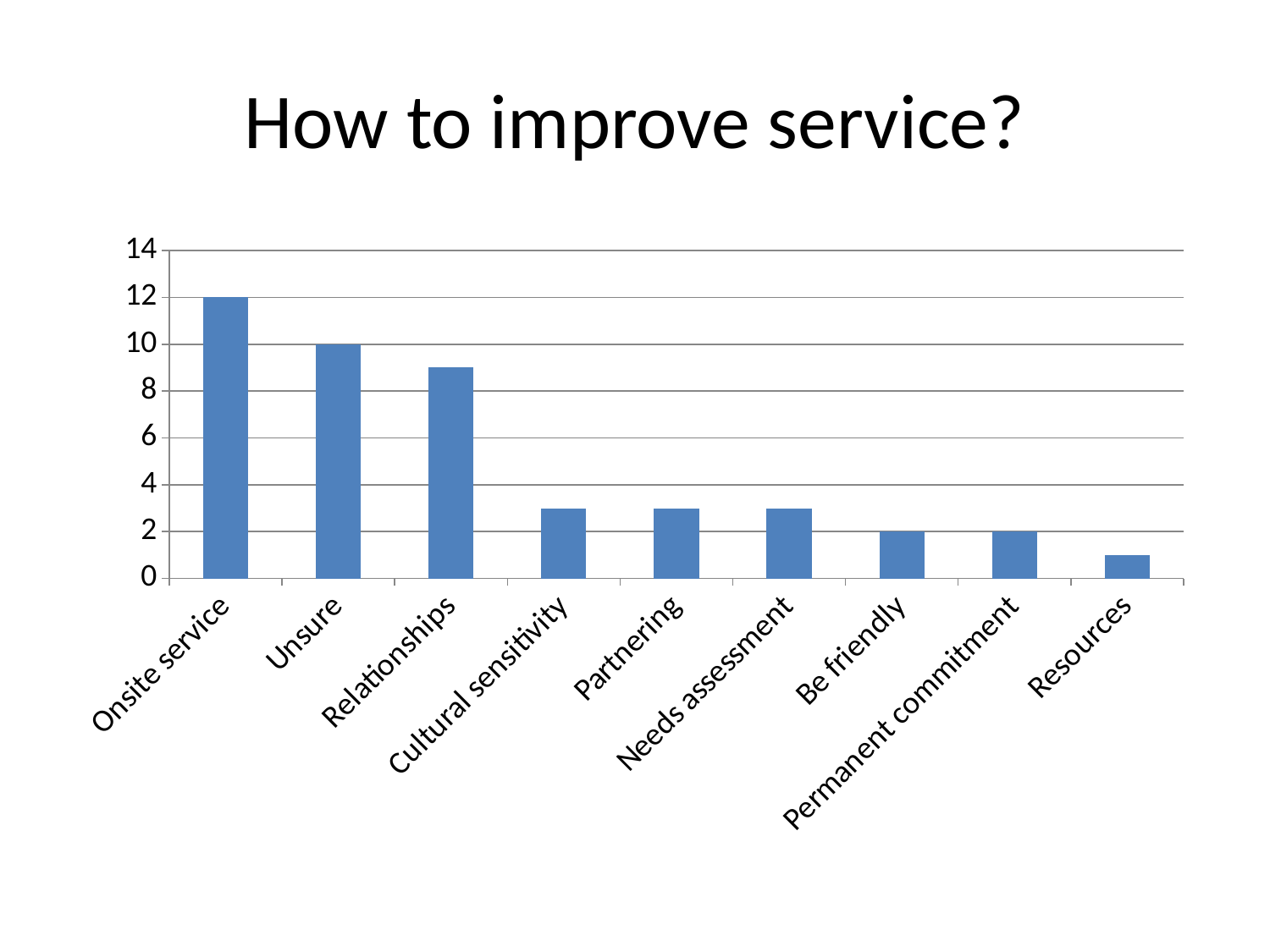
Which category has the highest value? Onsite service What is the title of the chart? How to improve service? How many categories are shown on the x axis? 9 What is the value for Unsure? 10 What type of chart is shown on the slide? bar chart Which category has the lowest value? Resources What is the difference between the values for Onsite service and Unsure? 2 Is the value for Relationships greater or less than 8? greater What is the value for Onsite service? 12 Do the values generally rise or fall from left to right along the x axis? fall Which is larger, the value for Unsure or the value for Relationships? Unsure What is the value for Be friendly? 2